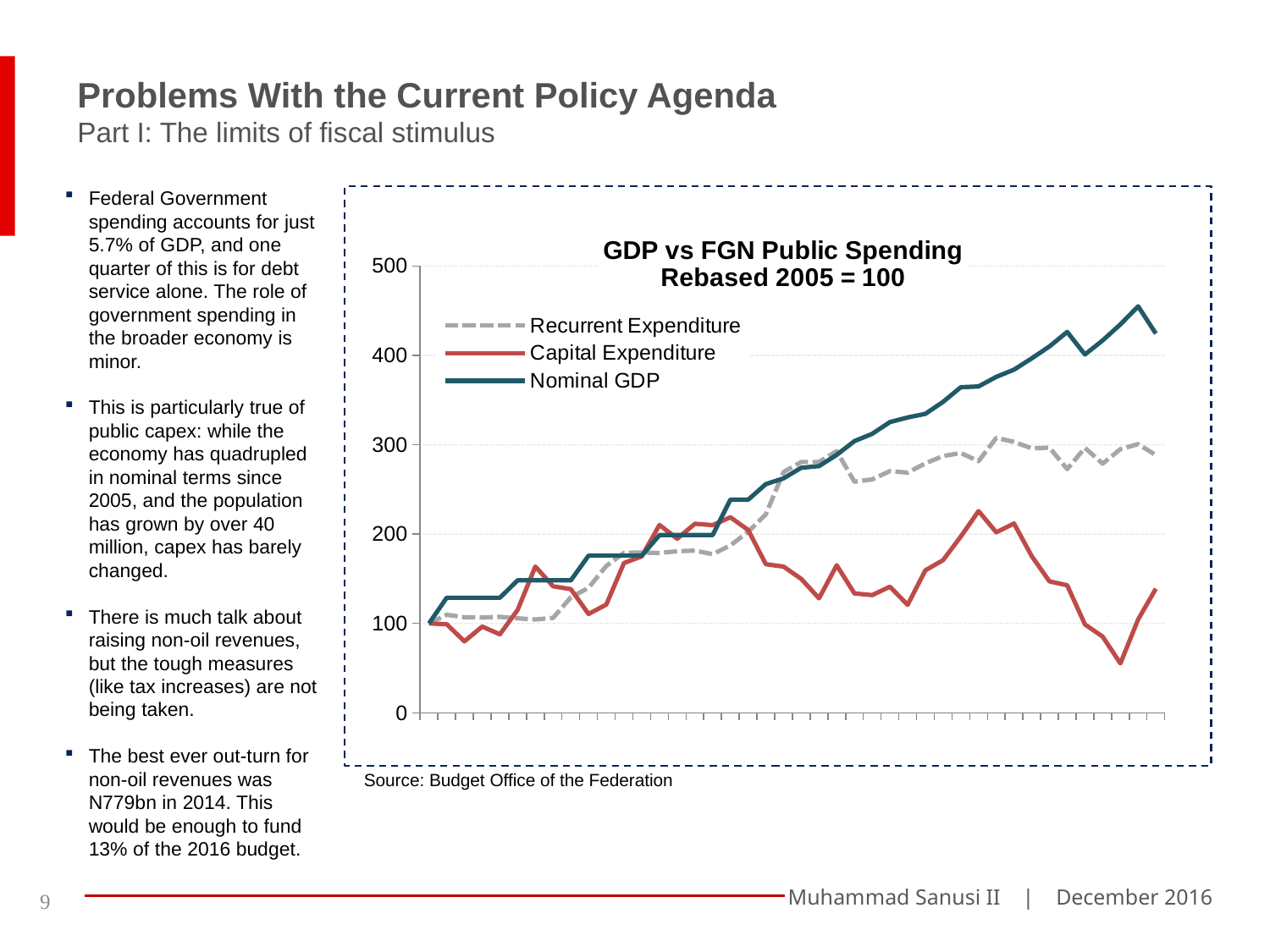
Does the Recurrent Expenditure line generally rise or fall from left to right? Rise At the right-hand end of the chart, which is larger: Nominal GDP or Capital Expenditure? Nominal GDP Which series has the lowest value at the right-hand end of the chart? Capital Expenditure What kind of chart is shown on the slide? Line chart Does the Nominal GDP line generally rise or fall from left to right? Rise How many series does the chart legend list? 3 Is the peak value of Nominal GDP greater or less than 400? greater Is the lowest value of Capital Expenditure greater or less than 100? less What is the title of the chart? GDP vs FGN Public Spending Rebased 2005 = 100 Is the peak value of Recurrent Expenditure greater or less than 400? less Which series in the chart is drawn with a dashed line? Recurrent Expenditure Which series reaches the highest value on the chart? Nominal GDP